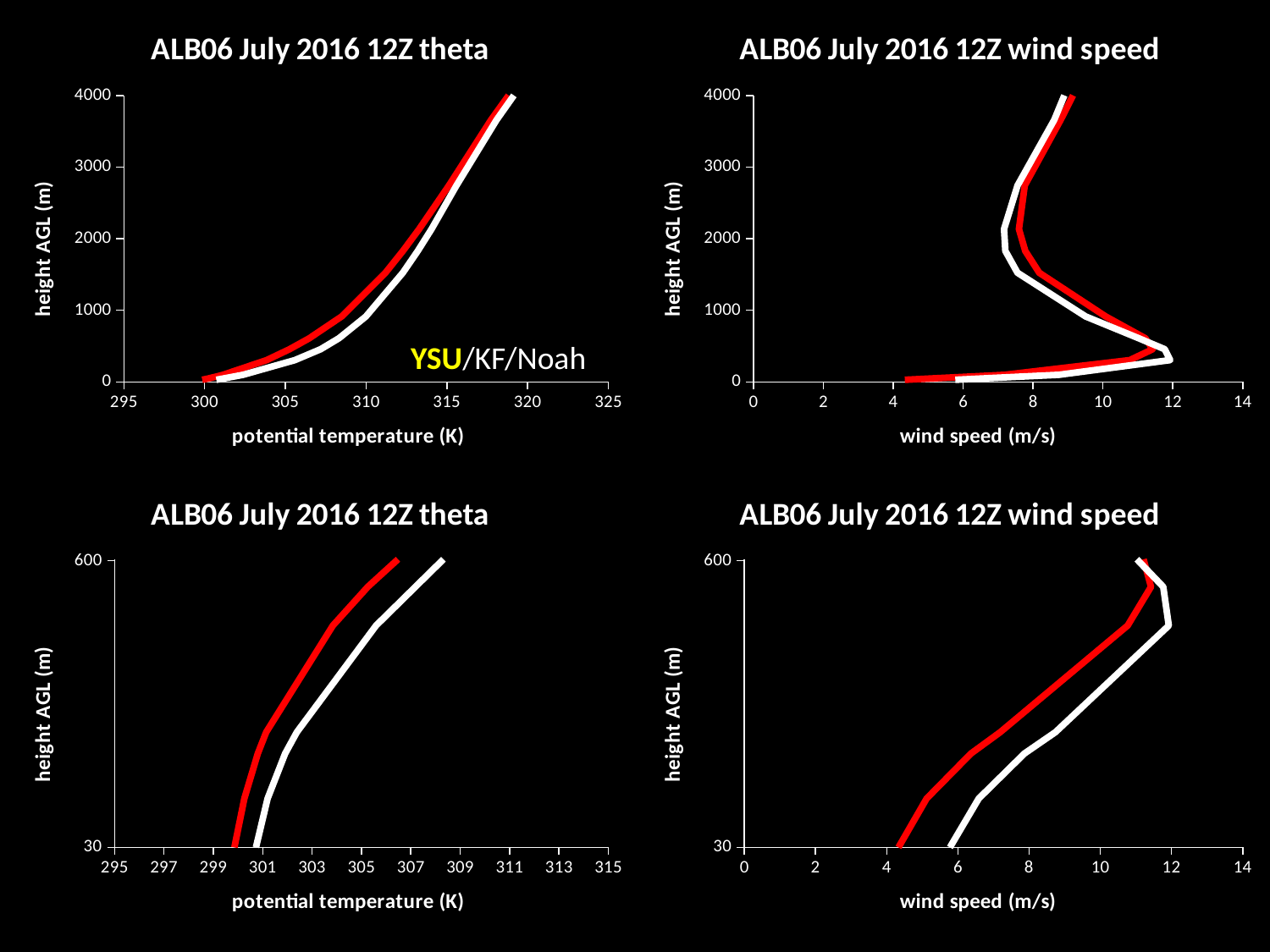
In the bottom-right chart (ALB06 July 2016 12Z wind speed, 30–600 m), does wind speed increase or decrease as height increases from 30 m to 600 m? increase In the top-right chart (ALB06 July 2016 12Z wind speed), is the peak wind speed of the white line near 500 m greater or less than 10 m/s? greater In the top-right chart (ALB06 July 2016 12Z wind speed), is the wind speed of the red line at 0 m height greater or less than 6 m/s? less In the bottom-left chart (ALB06 July 2016 12Z theta, 30–600 m), does potential temperature increase or decrease as height increases? increase In the bottom-right chart (ALB06 July 2016 12Z wind speed, 30–600 m), which line has the higher wind speed at 30 m, the red line or the white line? white line What kind of chart is the top-left chart titled "ALB06 July 2016 12Z theta"? line chart In the bottom-right chart (ALB06 July 2016 12Z wind speed, 30–600 m), is the wind speed of the red line at 30 m greater or less than 6 m/s? less What is the x-axis label of the top-right chart? wind speed (m/s) How many charts are shown on the slide? 4 In the bottom-left chart (ALB06 July 2016 12Z theta, 30–600 m), which line has the higher potential temperature at 600 m, the red line or the white line? white line